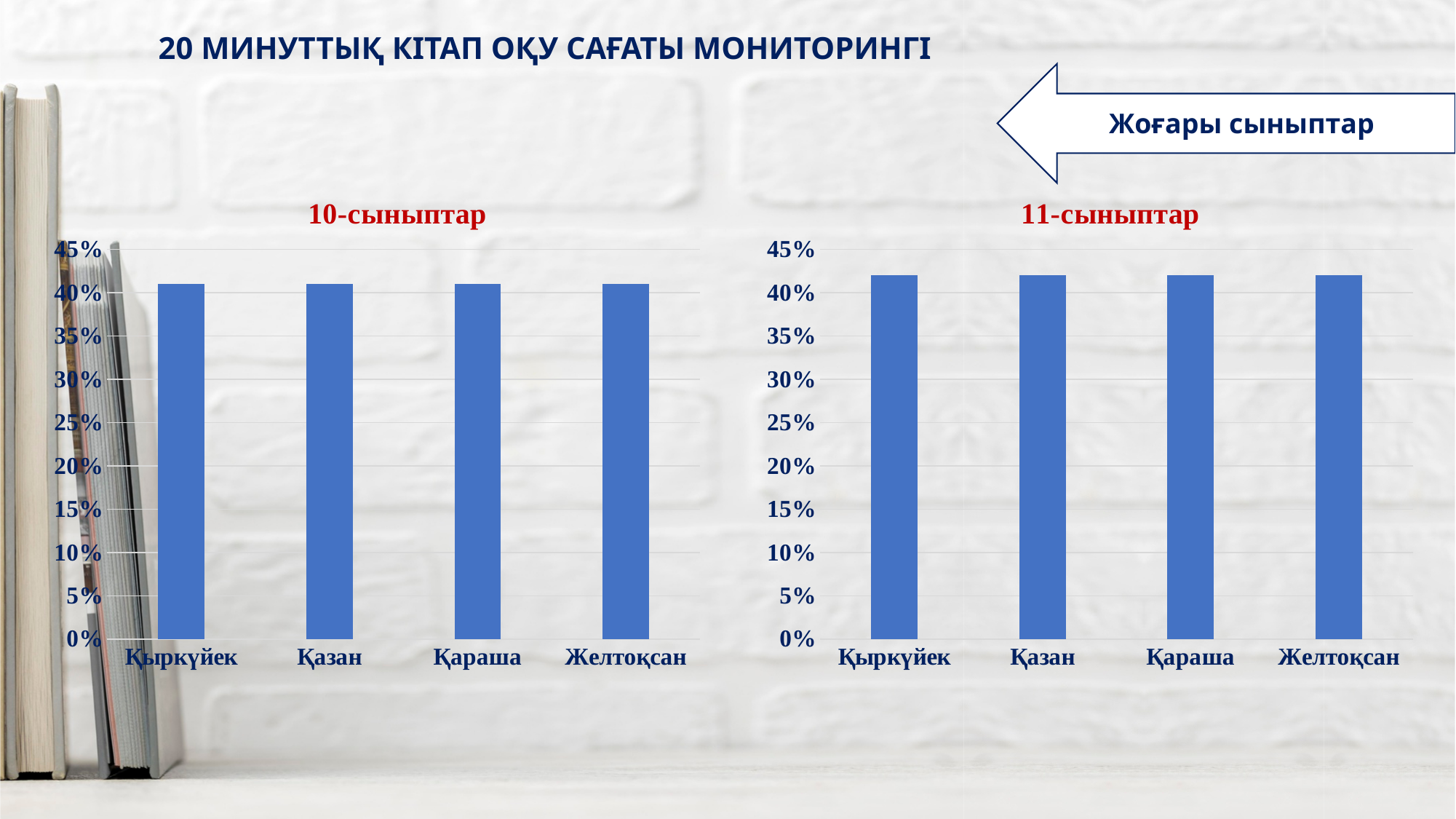
In the 11-сыныптар chart, is the value for Қазан greater or less than 30%? greater How many bars are there in the 11-сыныптар chart? 4 What is the label of the last category on the x axis of the 10-сыныптар chart? Желтоқсан In the 10-сыныптар chart, is the value for Желтоқсан greater or less than 45%? less How many categories are shown on the x axis of the 10-сыныптар chart? 4 What kind of chart is the 11-сыныптар chart? bar chart What is the title of the chart on the right side of the slide? 11-сыныптар What is the title of the chart on the left side of the slide? 10-сыныптар In the 10-сыныптар chart, is the value for Қыркүйек greater or less than 35%? greater What kind of chart is the 10-сыныптар chart? bar chart